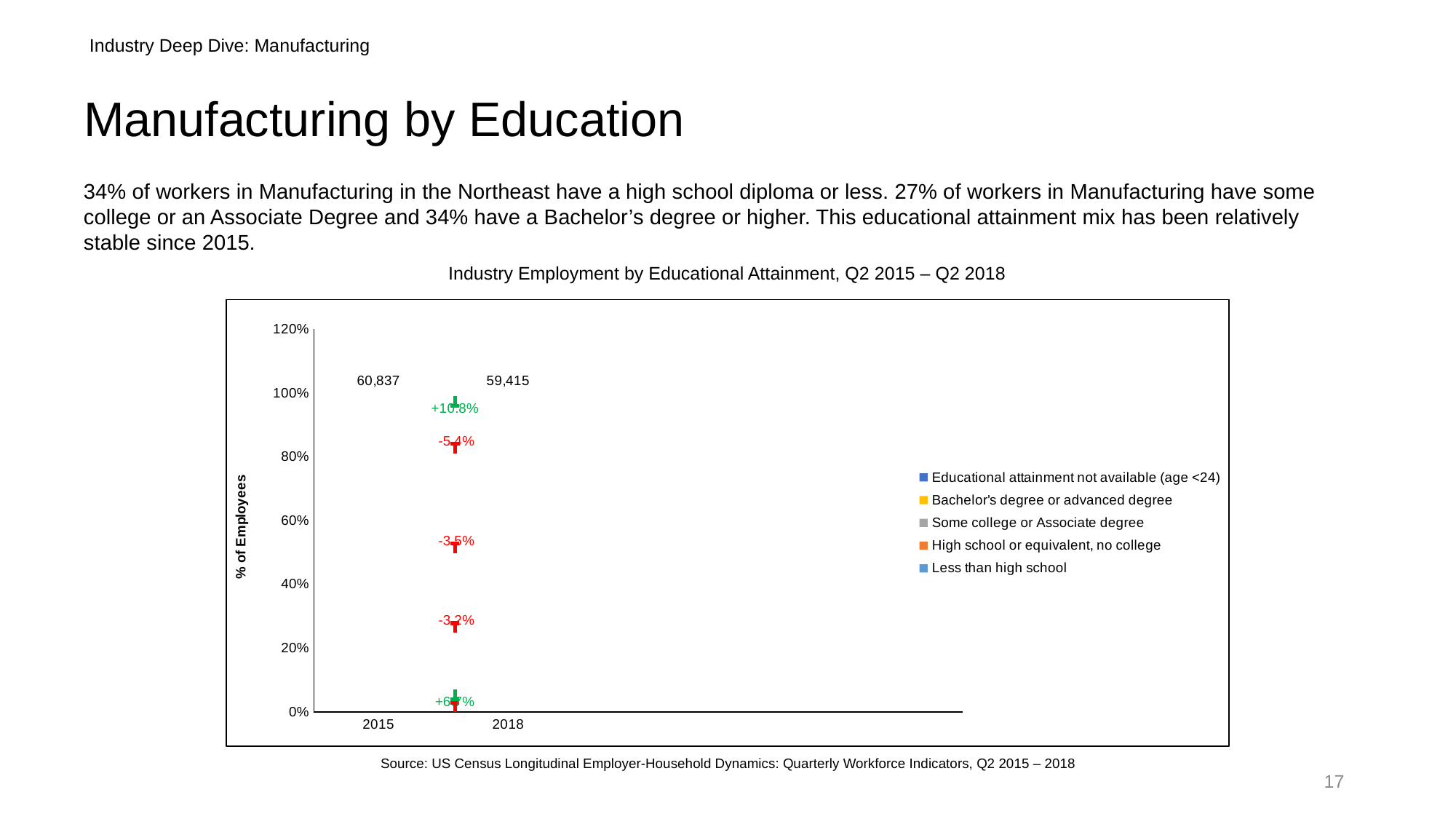
What is the bottommost percentage change label shown between the 2015 and 2018 bars? +6.7% How many years are shown on the x axis of the chart? 2 What total employment figure is labelled above the 2018 bar? 59,415 How many series does the chart's legend list? 5 What is the topmost percentage change label shown between the 2015 and 2018 bars? +10.8% Does the labelled total employment rise or fall from 2015 to 2018? fall What total employment figure is labelled above the 2015 bar? 60,837 What is the difference between the labelled totals for 2015 and 2018? 1,422 What is the title of the chart? Industry Employment by Educational Attainment, Q2 2015 – Q2 2018 Which year has the larger labelled total employment, 2015 or 2018? 2015 What is the label on the y axis of the chart? % of Employees What is the highest value shown on the y axis of the chart? 120%